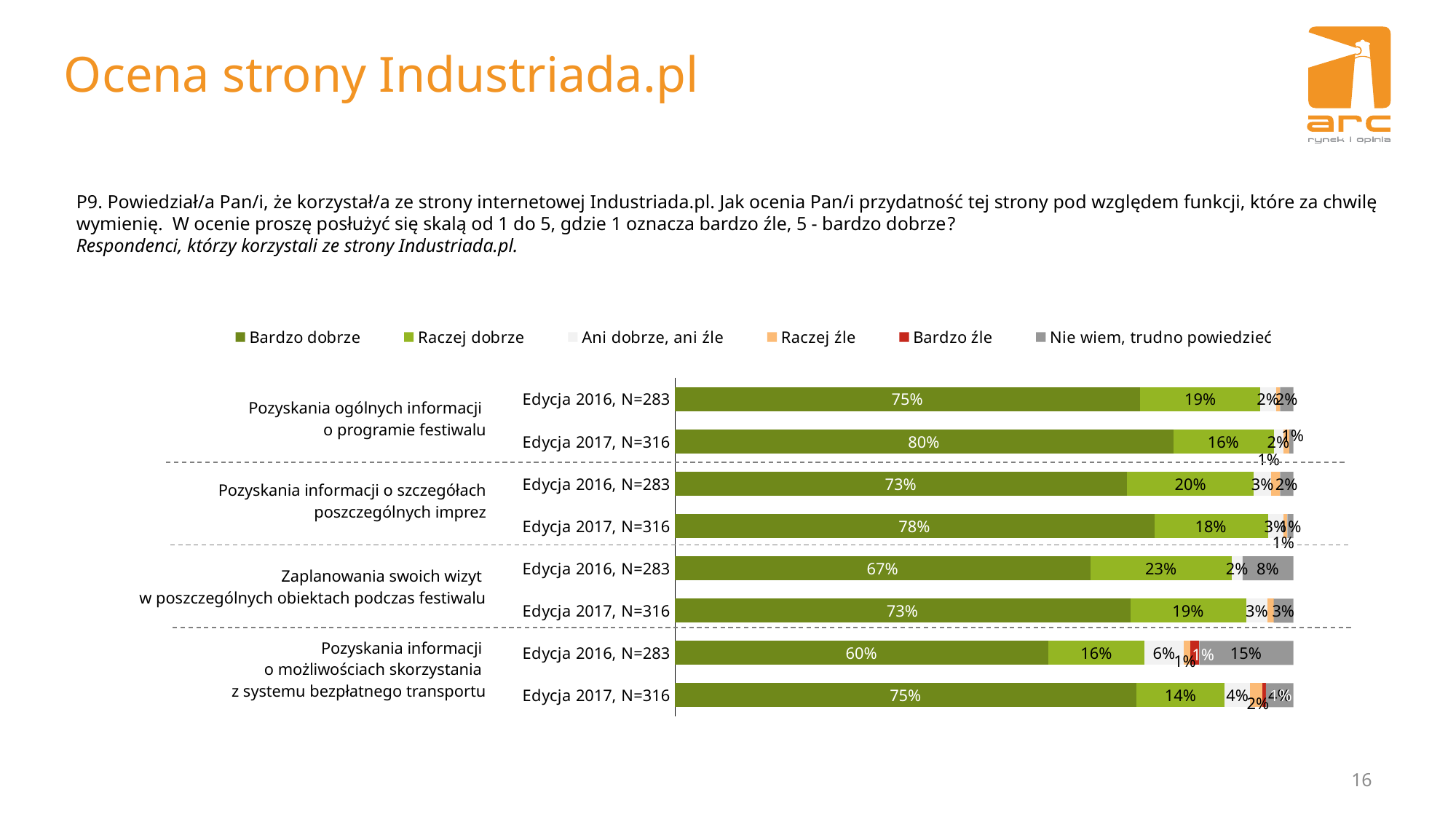
How many series does the legend list? 6 What kind of chart is shown on the slide? Stacked bar chart Which bar has the lowest 'Bardzo dobrze' share? Pozyskania informacji o możliwościach skorzystania z systemu bezpłatnego transportu, Edycja 2016, N=283 What is the 'Nie wiem, trudno powiedzieć' value for 'Pozyskania informacji o możliwościach skorzystania z systemu bezpłatnego transportu' in Edycja 2016, N=283? 15% What percentage of respondents rated the site 'Bardzo dobrze' for 'Pozyskania ogólnych informacji o programie festiwalu' in Edycja 2017, N=316? 80% What is the 'Raczej dobrze' value for 'Zaplanowania swoich wizyt w poszczególnych obiektach podczas festiwalu' in Edycja 2016, N=283? 23% Which bar has the highest 'Bardzo dobrze' share? Pozyskania ogólnych informacji o programie festiwalu, Edycja 2017, N=316 What is the first entry in the chart legend? Bardzo dobrze For 'Pozyskania informacji o szczegółach poszczególnych imprez', which edition has the larger 'Bardzo dobrze' share, Edycja 2016 or Edycja 2017? Edycja 2017 What is the 'Ani dobrze, ani źle' value for 'Pozyskania informacji o możliwościach skorzystania z systemu bezpłatnego transportu' in Edycja 2016, N=283? 6% How many bars are plotted in the chart? 8 By how many percentage points did the 'Bardzo dobrze' share for 'Pozyskania informacji o możliwościach skorzystania z systemu bezpłatnego transportu' change from Edycja 2016 to Edycja 2017? 15 percentage points